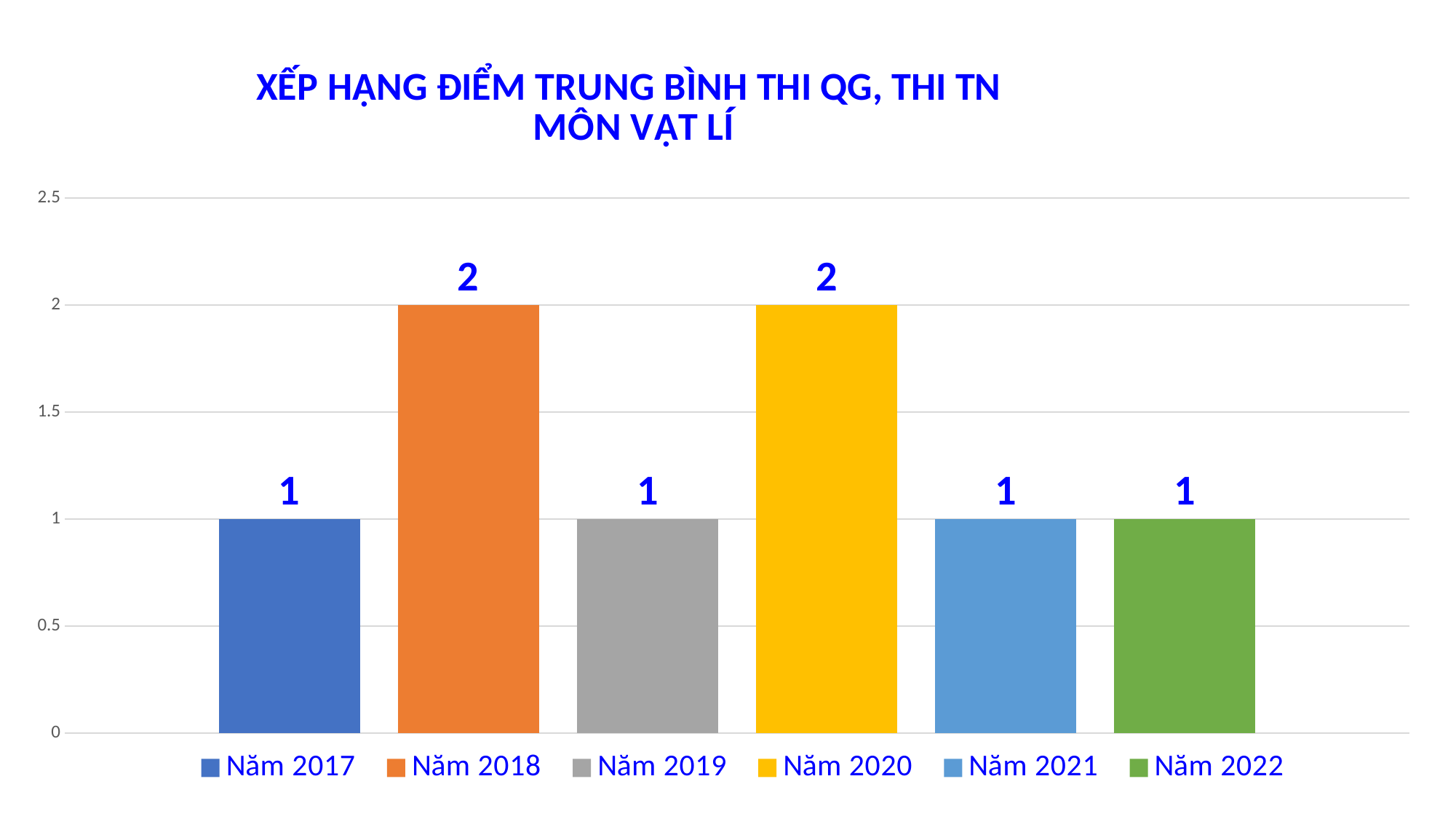
What is the difference between the values for Năm 2018 and Năm 2019? 1 Is the value for Năm 2018 greater or less than 1.5? greater What is the value for Năm 2022? 1 What colour is the bar for Năm 2020? yellow What is the value for Năm 2018? 2 Which is larger, the value for Năm 2020 or the value for Năm 2021? Năm 2020 How many bars are plotted on the chart? 6 What is the value for Năm 2020? 2 What is the value for Năm 2017? 1 What kind of chart is shown on the slide? bar chart Is the value for Năm 2021 greater or less than 1.5? less How many entries does the legend list? 6